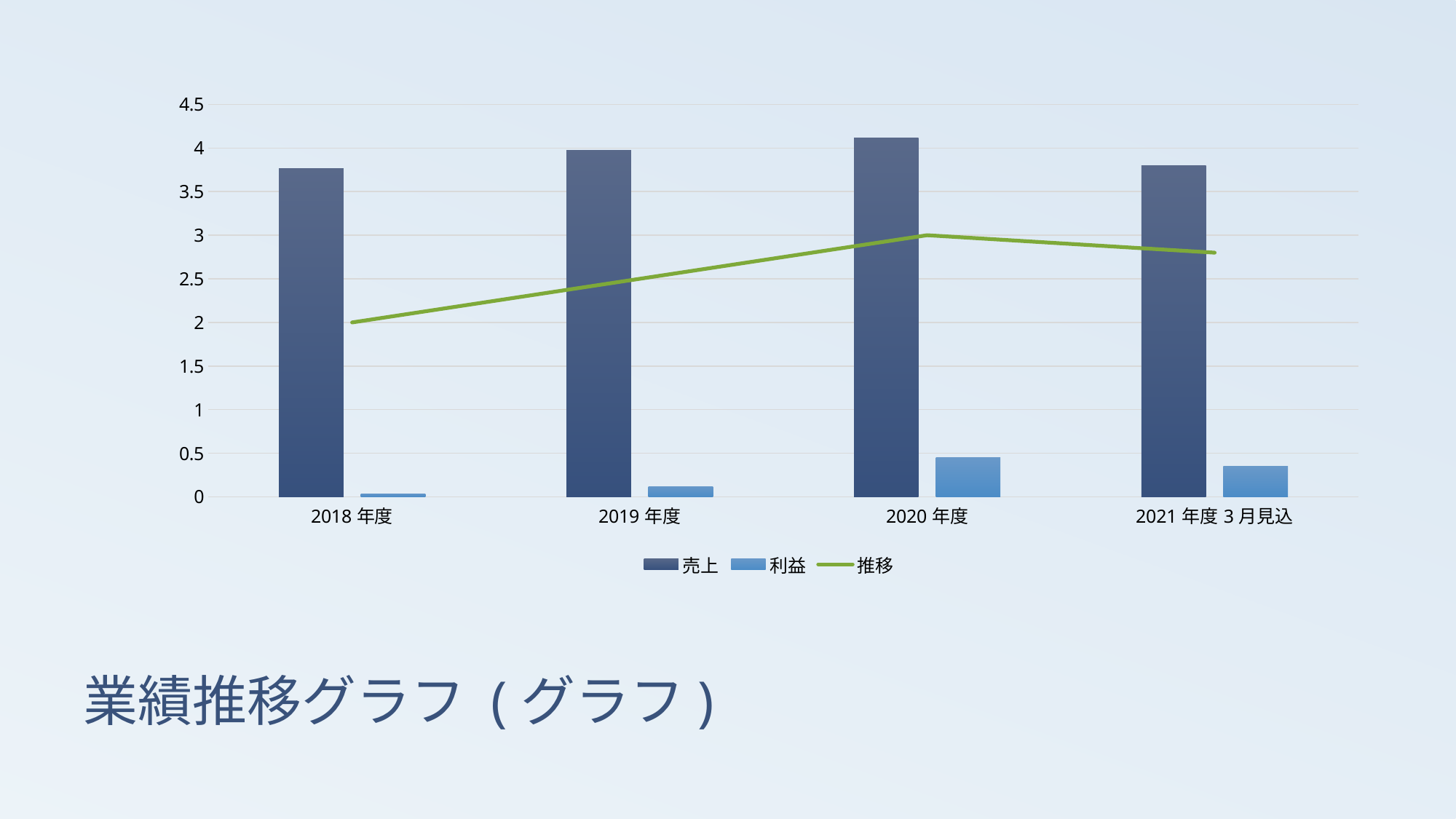
What is the value of the 推移 line for 2020 年度? 3 Which is larger, the 利益 value for 2020 年度 or for 2021 年度 3 月見込? 2020 年度 Which category has the highest 売上 bar? 2020 年度 Which category has the lowest 利益 bar? 2018 年度 Is the 利益 value for 2020 年度 greater or less than 0.5? less What kind of chart is shown on the slide? A bar chart combined with a line How many series does the legend list? 3 What are the three series named in the legend? 売上, 利益, 推移 Which category has the highest 利益 bar? 2020 年度 What is the value of the 推移 line for 2018 年度? 2 Is the 売上 value for 2020 年度 greater or less than 4? greater How many categories are shown on the x axis? 4